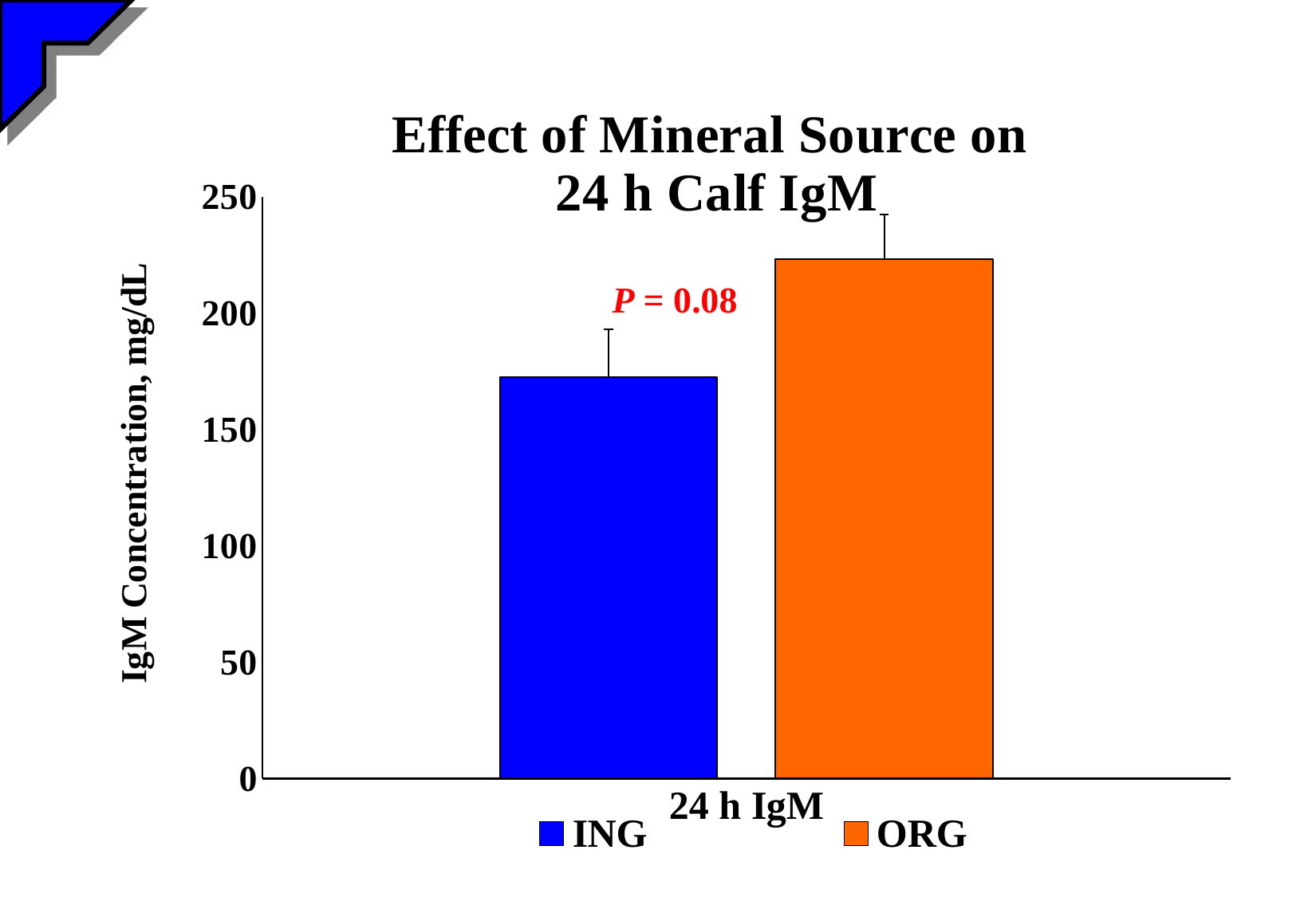
Which series has the lowest 24 h IgM concentration? ING Is the value for ING greater or less than 200? less Is the value for ORG greater or less than 200? greater What is the label on the y axis? IgM Concentration, mg/dL What is the title of the chart? Effect of Mineral Source on 24 h Calf IgM Is the value for ORG greater or less than 250? less What kind of chart is shown on the slide? bar chart How many series does the legend list? 2 Which series has the higher 24 h IgM concentration, ING or ORG? ORG What P value is printed on the chart? P = 0.08 How many categories are shown on the x axis? 1